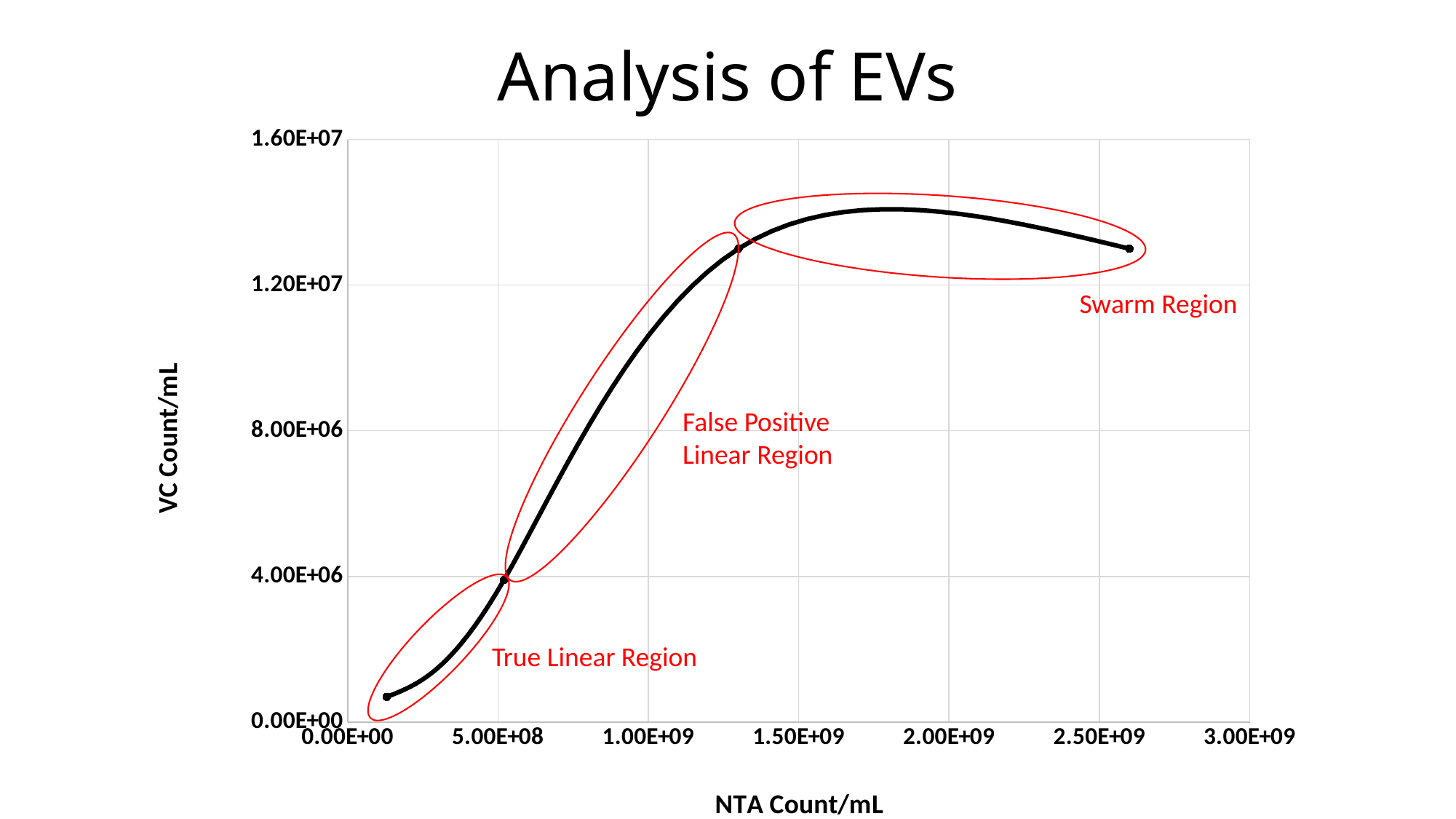
Which is larger: the VC Count/mL value of the first data point or of the last data point? The last data point Is the highest point of the curve greater or less than 1.60E+07 VC Count/mL? less What is the title of the chart? Analysis of EVs Is the VC Count/mL value of the first data point (near 0.00E+00 NTA Count/mL) greater or less than 4.00E+06? less What is the label of the y axis? VC Count/mL Is the VC Count/mL value of the last data point (near 2.50E+09 NTA Count/mL) greater or less than 1.20E+07? greater What kind of chart is shown on the slide? Line chart Does the VC Count/mL value rise or fall as NTA Count/mL increases from 0.00E+00 to 1.00E+09? rise Which annotated region covers the highest NTA Count/mL values? Swarm Region Does the curve rise or fall between 2.00E+09 and 2.50E+09 NTA Count/mL? fall How many data points are marked on the plotted line? 4